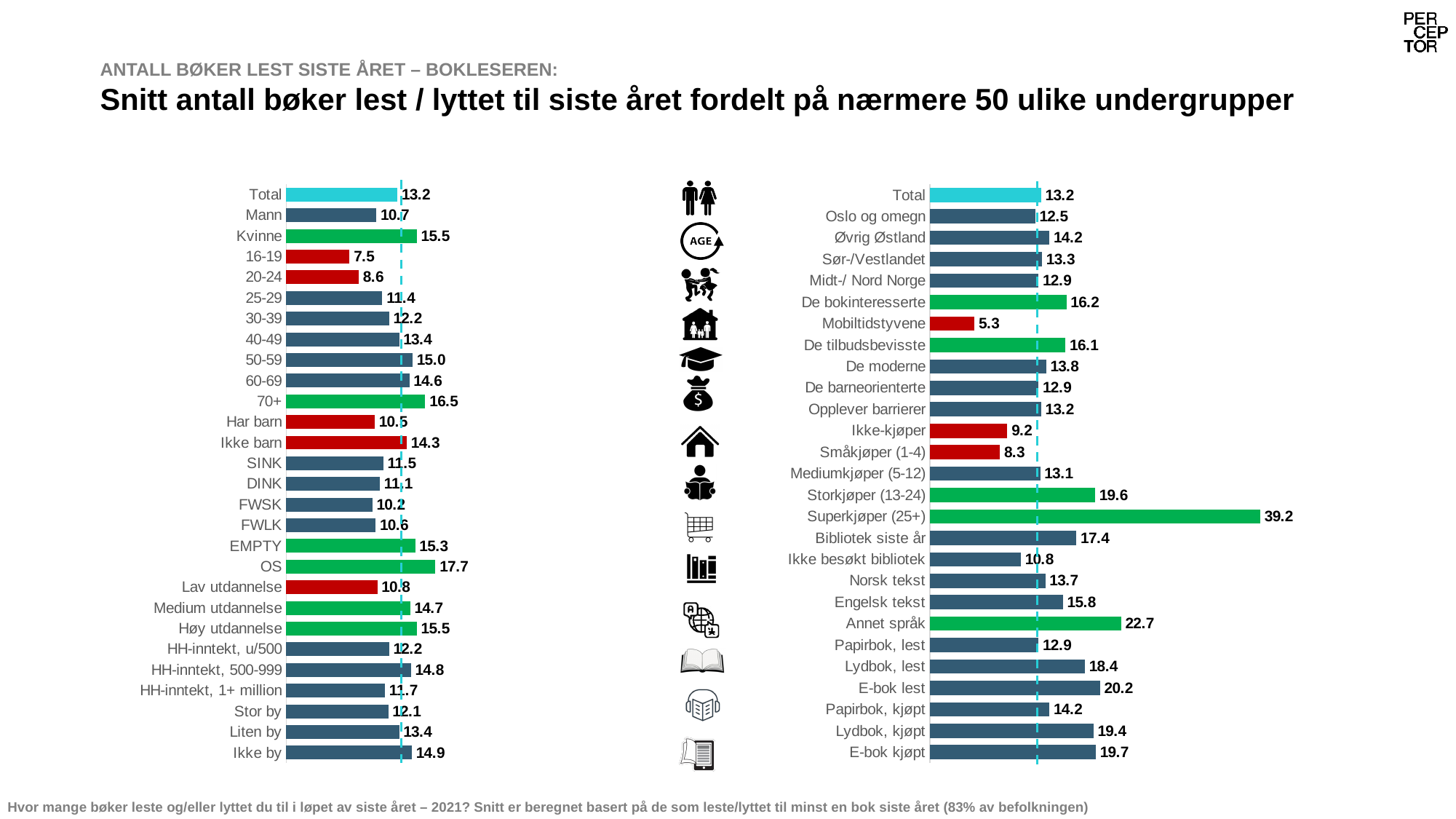
In the left chart, which category has the highest value? OS In the left chart, what is the difference between the values for Kvinne and Mann? 4.8 In the left chart, what is the value for Total? 13.2 What kind of chart is shown on the left of the slide? Bar chart In the right chart, which category has the lowest value? Mobiltidstyvene In the right chart, which is larger, the value for Lydbok, kjøpt or the value for Papirbok, kjøpt? Lydbok, kjøpt In the left chart, which category has the lowest value? 16-19 In the left chart, what is the value for Kvinne? 15.5 In the right chart, what is the value for Annet språk? 22.7 In the right chart, what is the difference between the values for Bibliotek siste år and Ikke besøkt bibliotek? 6.6 In the left chart, which is larger, the value for Har barn or the value for Ikke barn? Ikke barn In the right chart, what is the value for Superkjøper (25+)? 39.2